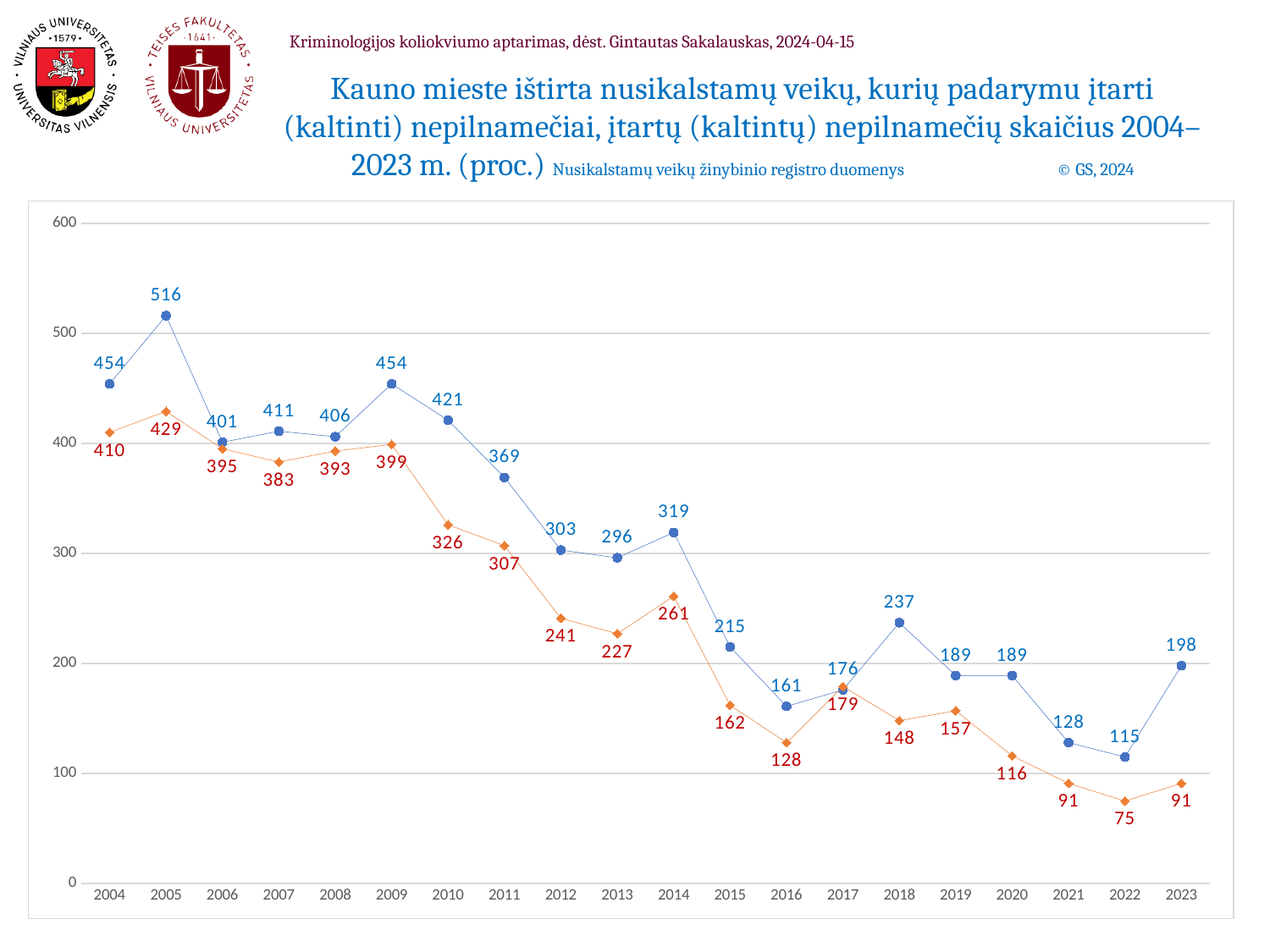
Is the orange value in 2014 greater or less than 300? less What kind of chart is shown on the slide? line chart How many years are shown on the x axis? 20 What is the difference between the blue values in 2004 and 2023? 256 What is the difference between the blue and orange values in 2018? 89 Do the values of the orange line generally rise or fall from 2004 to 2023? fall Which is larger: the blue value in 2009 or the blue value in 2010? 2009 What is the value of the orange line in 2022? 75 What is the value of the blue line in 2005? 516 What is the value of the blue line in 2023? 198 In which year does the orange line reach its lowest value? 2022 In which year does the blue line reach its highest value? 2005